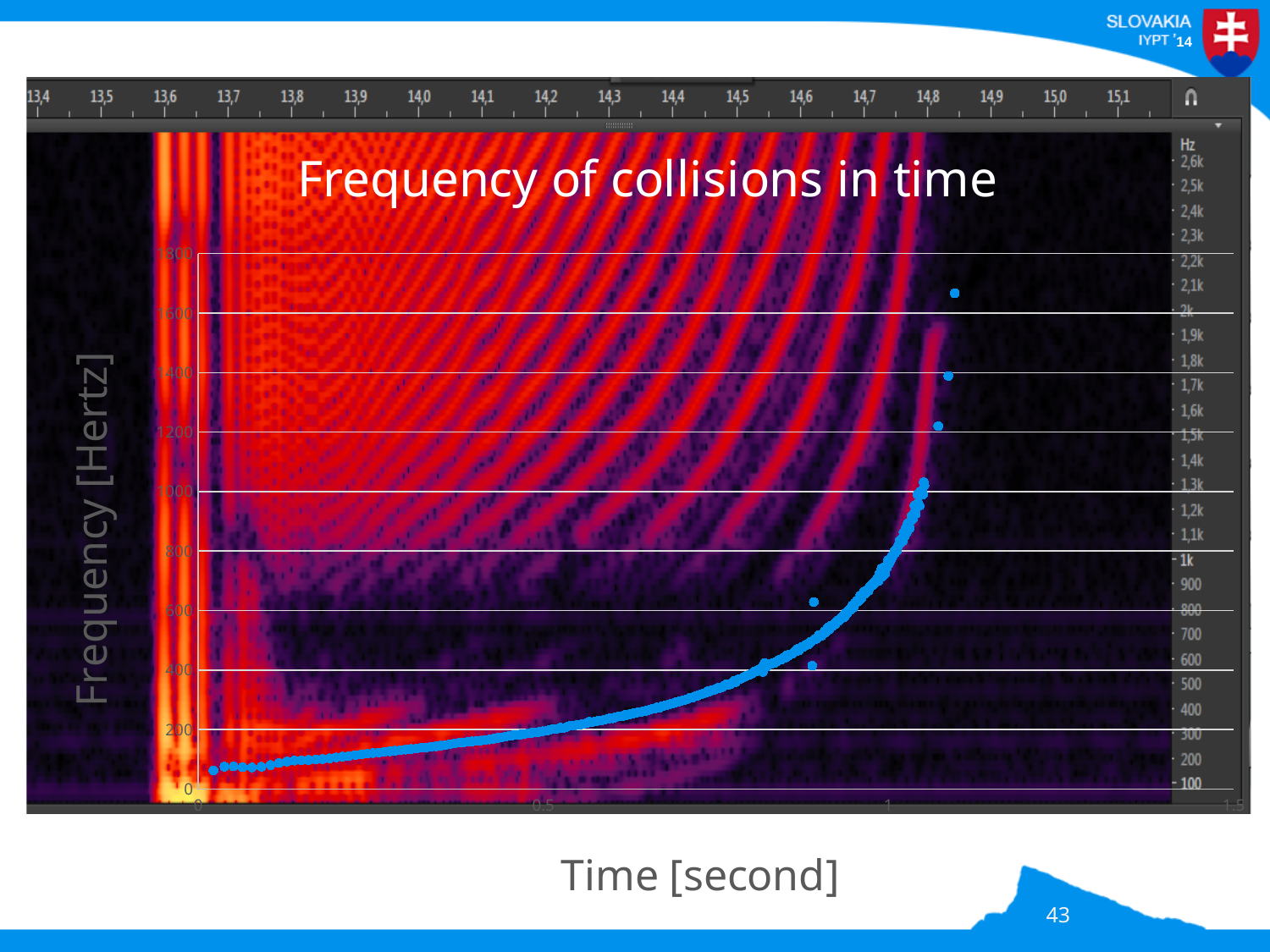
Is the highest plotted frequency value greater or less than 1400 Hertz? greater Do the plotted frequency values rise or fall as time increases along the x axis? rise Is the frequency value at time 0.5 seconds greater or less than 400 Hertz? less What is the label of the vertical axis? Frequency [Hertz] Is the frequency value at time 1 second greater or less than 600 Hertz? greater What kind of chart is shown on the slide? scatter chart Is the frequency at time 1 second greater than the frequency at time 0.5 seconds? yes What is the highest tick value shown on the vertical axis? 1800 What is the title of the chart? Frequency of collisions in time